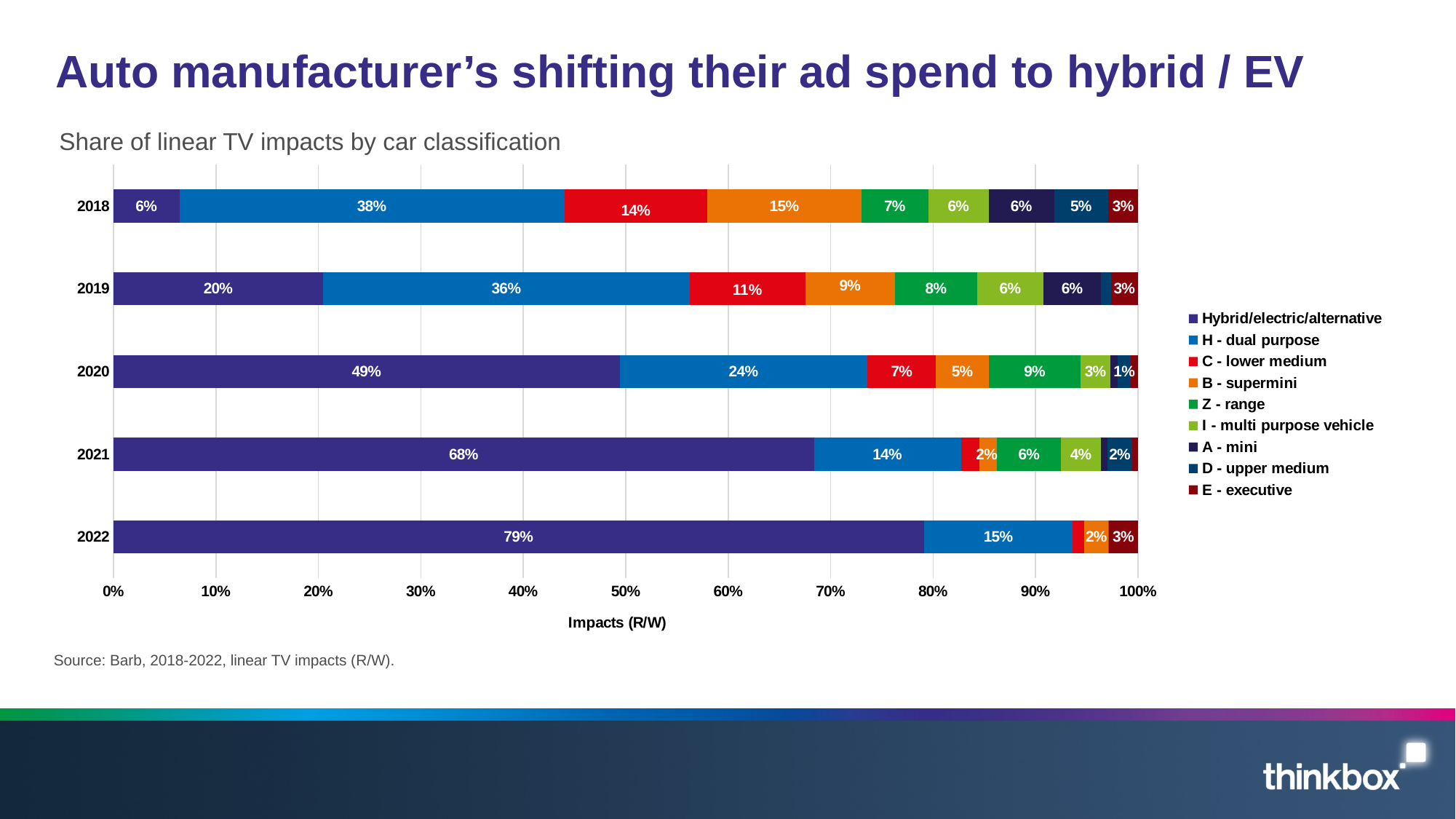
What kind of chart is shown on the slide? stacked bar chart Which was larger in 2019: the share for H - dual purpose or the share for C - lower medium? H - dual purpose What was the share for B - supermini in 2019? 9% What was the share for Z - range in 2020? 9% Does the Hybrid/electric/alternative share rise or fall from 2018 to 2022? rise How many series does the legend list? 9 What share of linear TV impacts did Hybrid/electric/alternative have in 2022? 79% In which year was the Hybrid/electric/alternative share highest? 2022 What share of linear TV impacts did H - dual purpose have in 2018? 38% How many years are shown on the chart? 5 How much did the Hybrid/electric/alternative share increase from 2018 to 2022? 73 percentage points In which year was the Hybrid/electric/alternative share lowest? 2018